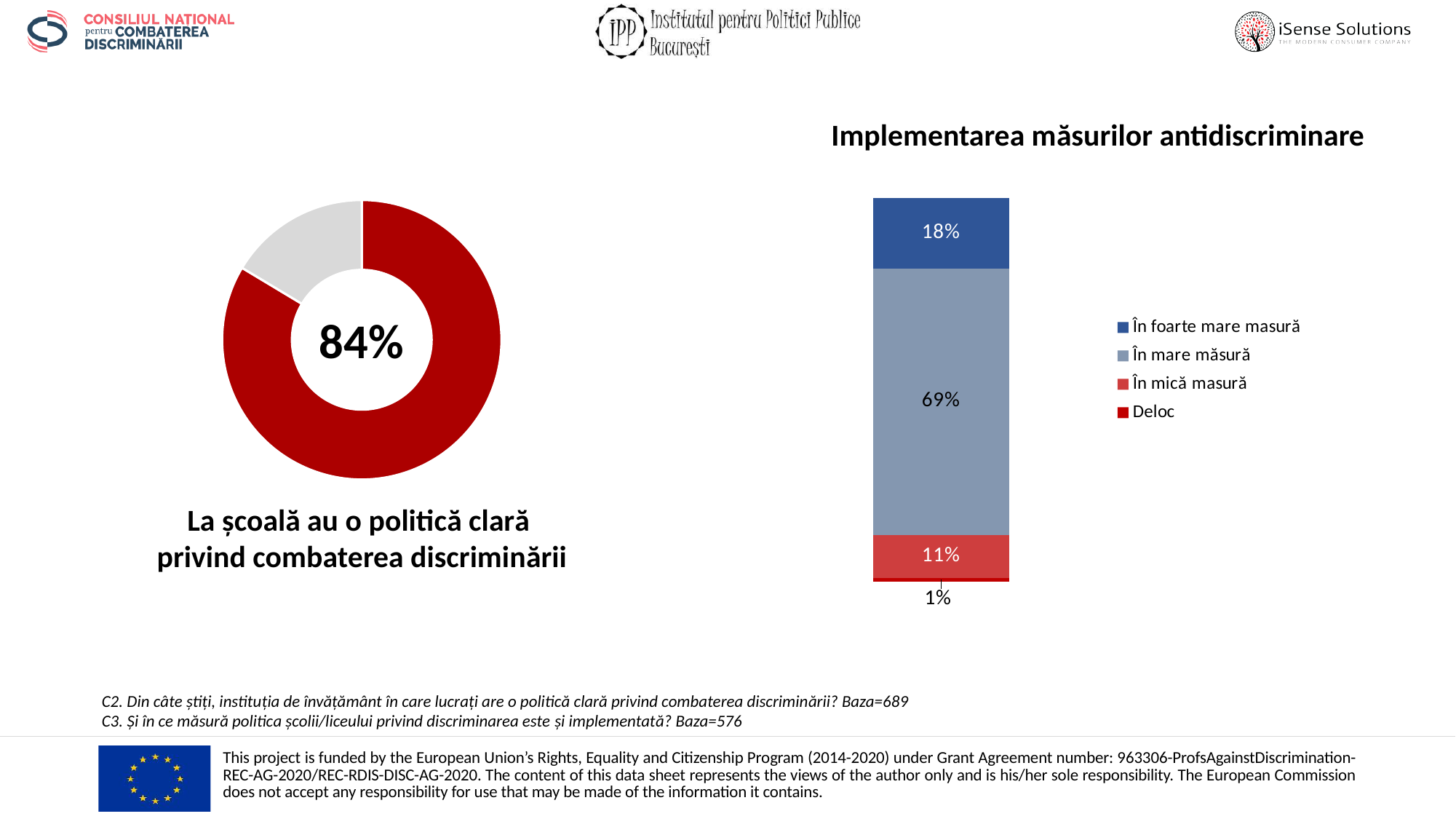
In the chart titled "Implementarea măsurilor antidiscriminare", what is the difference between the values for "În foarte mare masură" and "În mică masură"? 7% In the chart titled "Implementarea măsurilor antidiscriminare", which category has the lowest value? Deloc In the chart titled "Implementarea măsurilor antidiscriminare", which category has the highest value? În mare măsură In the chart titled "Implementarea măsurilor antidiscriminare", which is larger: "În foarte mare masură" or "În mică masură"? În foarte mare masură In the chart titled "Implementarea măsurilor antidiscriminare", what is the value for "În mare măsură"? 69% In the chart titled "Implementarea măsurilor antidiscriminare", what is the value for "În foarte mare masură"? 18% How many series does the legend of the chart titled "Implementarea măsurilor antidiscriminare" list? 4 What value is shown in the centre of the donut chart on the left of the slide? 84% What kind of chart is the chart titled "Implementarea măsurilor antidiscriminare"? Stacked bar chart In the chart titled "Implementarea măsurilor antidiscriminare", what is the value for "Deloc"? 1% In the chart titled "Implementarea măsurilor antidiscriminare", what is the total of the stacked bar? 99% What kind of chart is the chart on the left of the slide? Donut chart